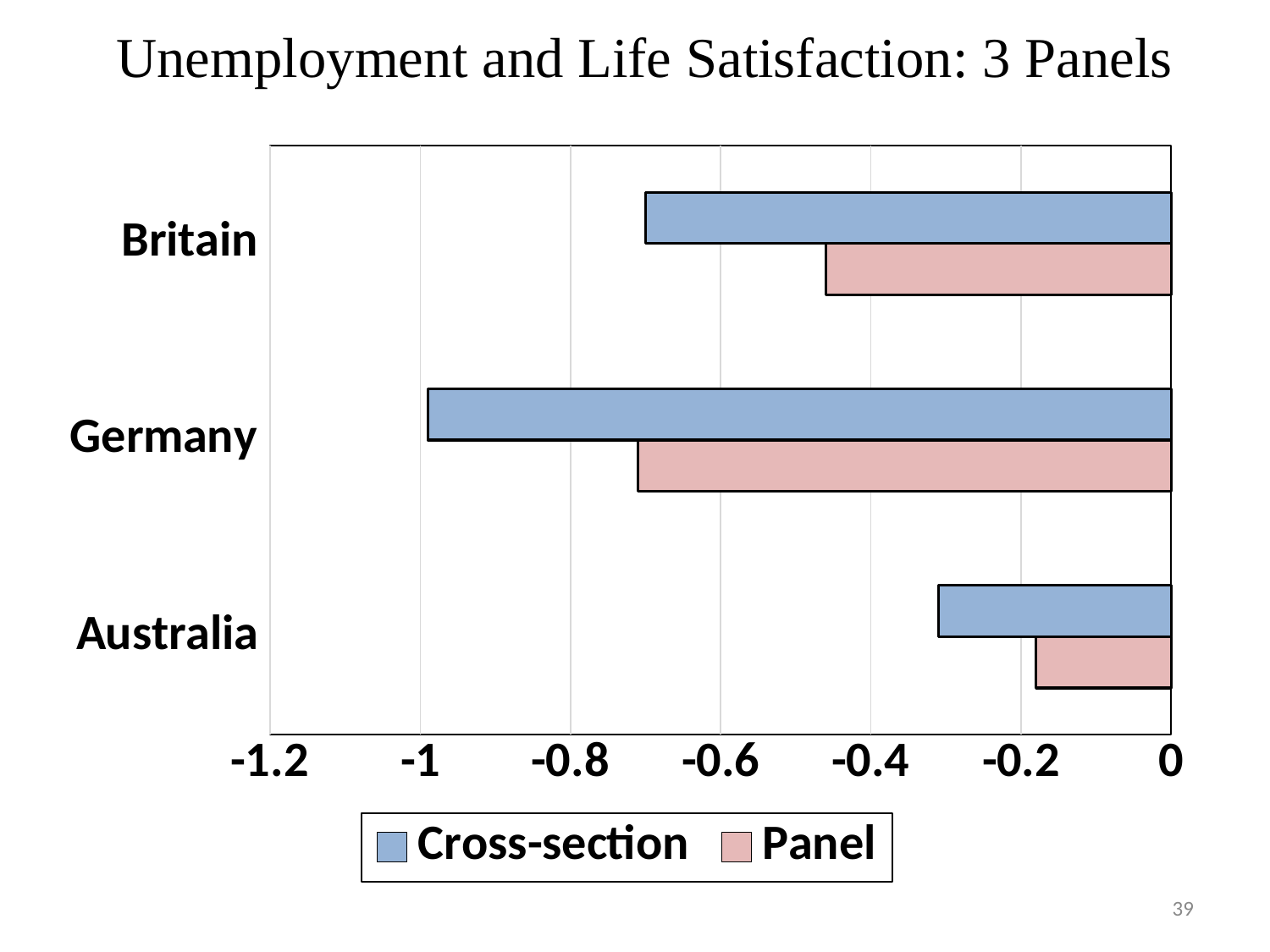
Is the Cross-section value for Australia greater or less than -0.4? greater Is the Cross-section value for Germany greater or less than -0.8? less Which country has the longest Cross-section bar (the most negative value)? Germany How many countries are shown on the chart? 3 What kind of chart is shown on the slide? bar chart How many series does the legend list? 2 Which country has the shortest Cross-section bar (the value closest to zero)? Australia Is the Cross-section value for Britain greater or less than -0.6? less What are the two series named in the legend? Cross-section and Panel What is the title of the chart? Unemployment and Life Satisfaction: 3 Panels Which country has the shortest Panel bar (the value closest to zero)? Australia Which is more negative for Germany, the Cross-section value or the Panel value? Cross-section